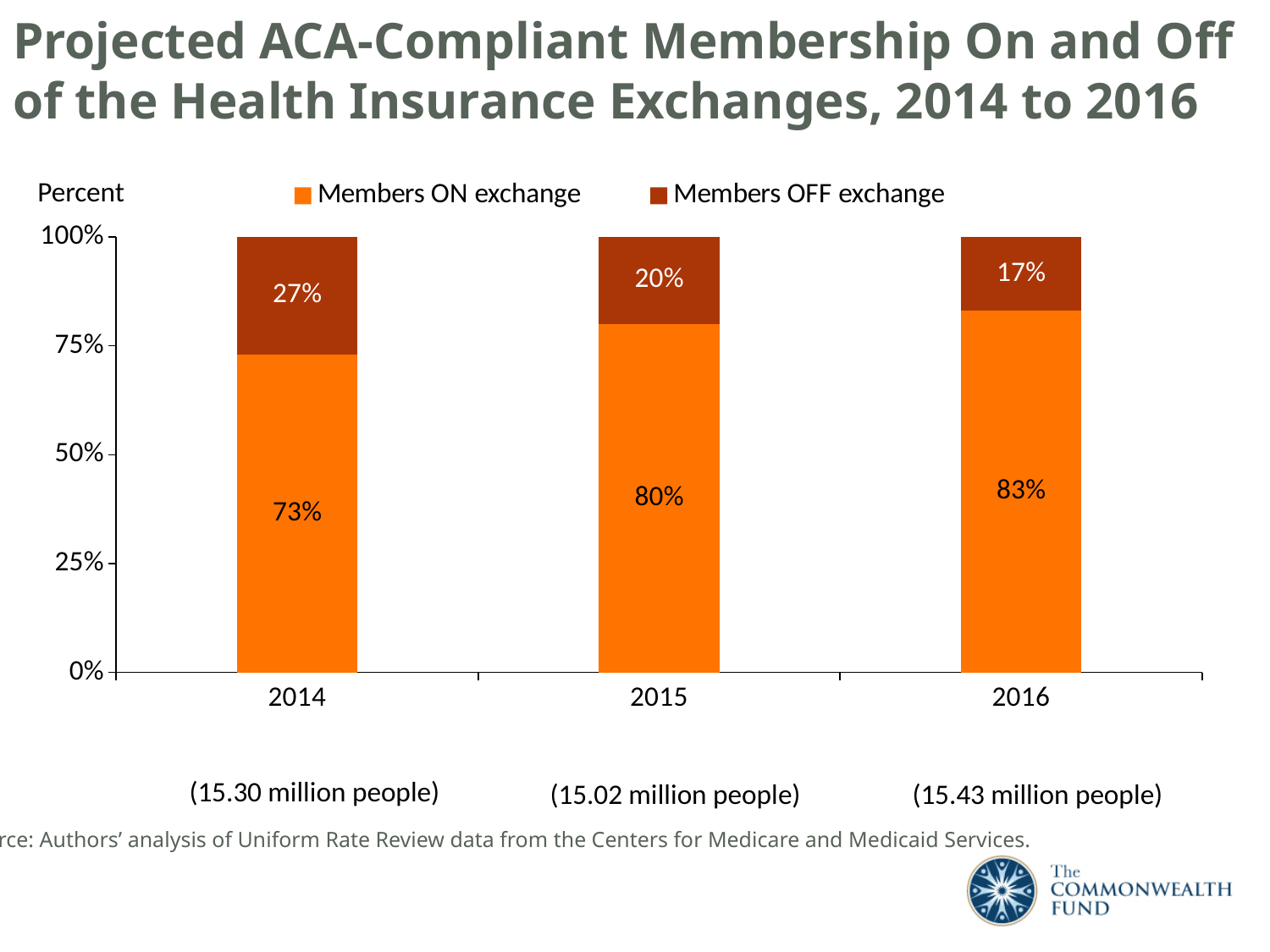
Which year has the highest share of members ON exchange? 2016 What is the difference in percentage points between members ON exchange in 2016 and in 2014? 10 How many years are shown on the x axis? 3 Which year has the lowest share of members OFF exchange? 2016 What percentage of members were OFF exchange in 2016? 17% How many series does the legend list? 2 Does the share of members ON exchange rise or fall from 2014 to 2016? Rise What percentage of members were ON exchange in 2014? 73% What percentage of members were ON exchange in 2015? 80% What kind of chart is shown on the slide? Stacked bar chart What is the total number of people noted for 2016? 15.43 million people Is the share of members OFF exchange larger in 2014 or in 2015? 2014